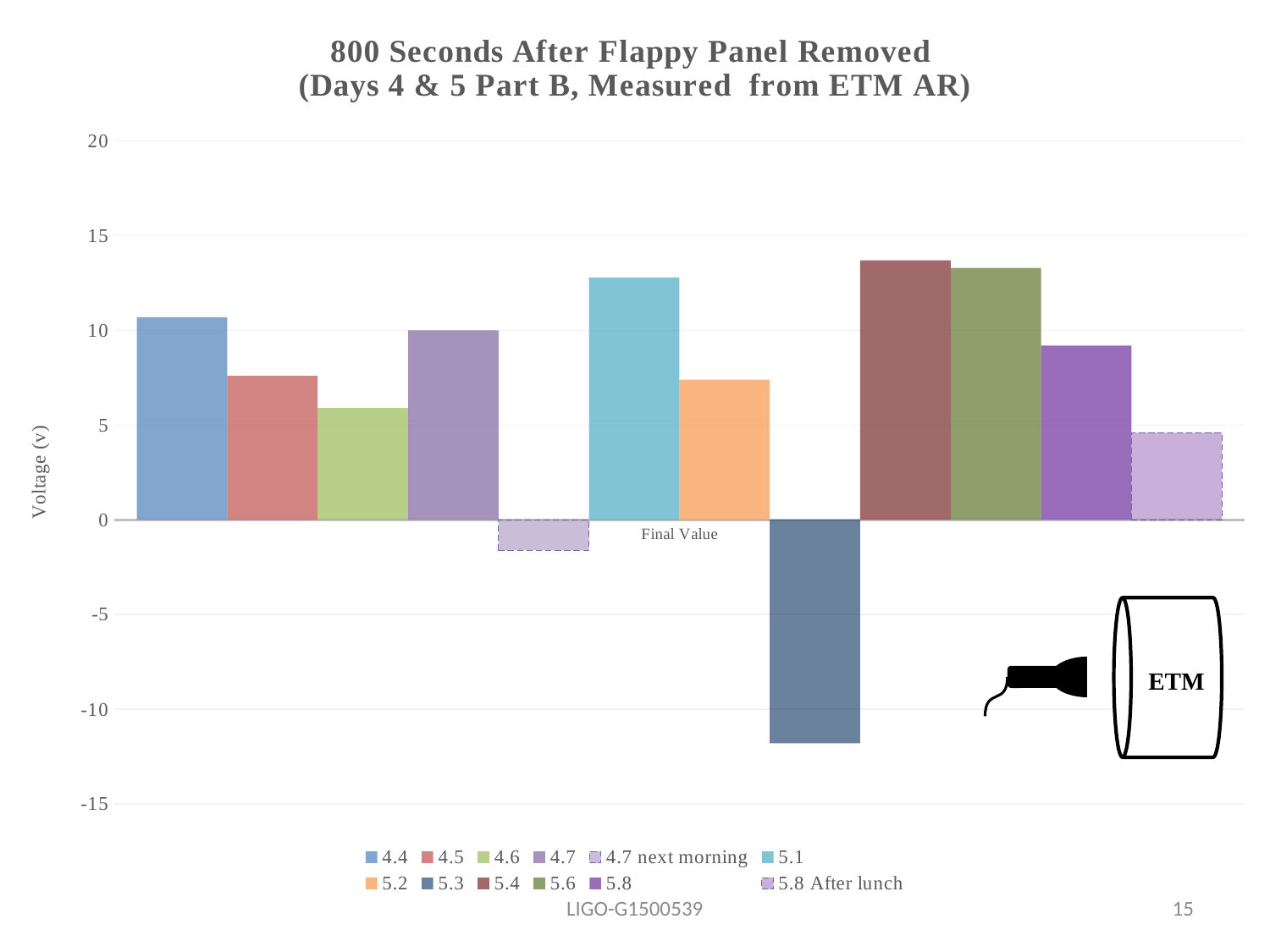
Which is larger, the value for 5.8 or the value for 5.8 After lunch? 5.8 Is the value for 4.4 greater or less than 10? greater Is the value for 5.3 greater or less than -10? less Is the value for 5.1 greater or less than 10? greater How many series does the legend list? 12 Which is larger, the value for 4.4 or the value for 4.5? 4.4 What kind of chart is shown on the slide? bar chart Which is larger, the value for 5.1 or the value for 5.2? 5.1 What is the label on the vertical axis of the chart? Voltage (v) Which series has the lowest value on the chart? 5.3